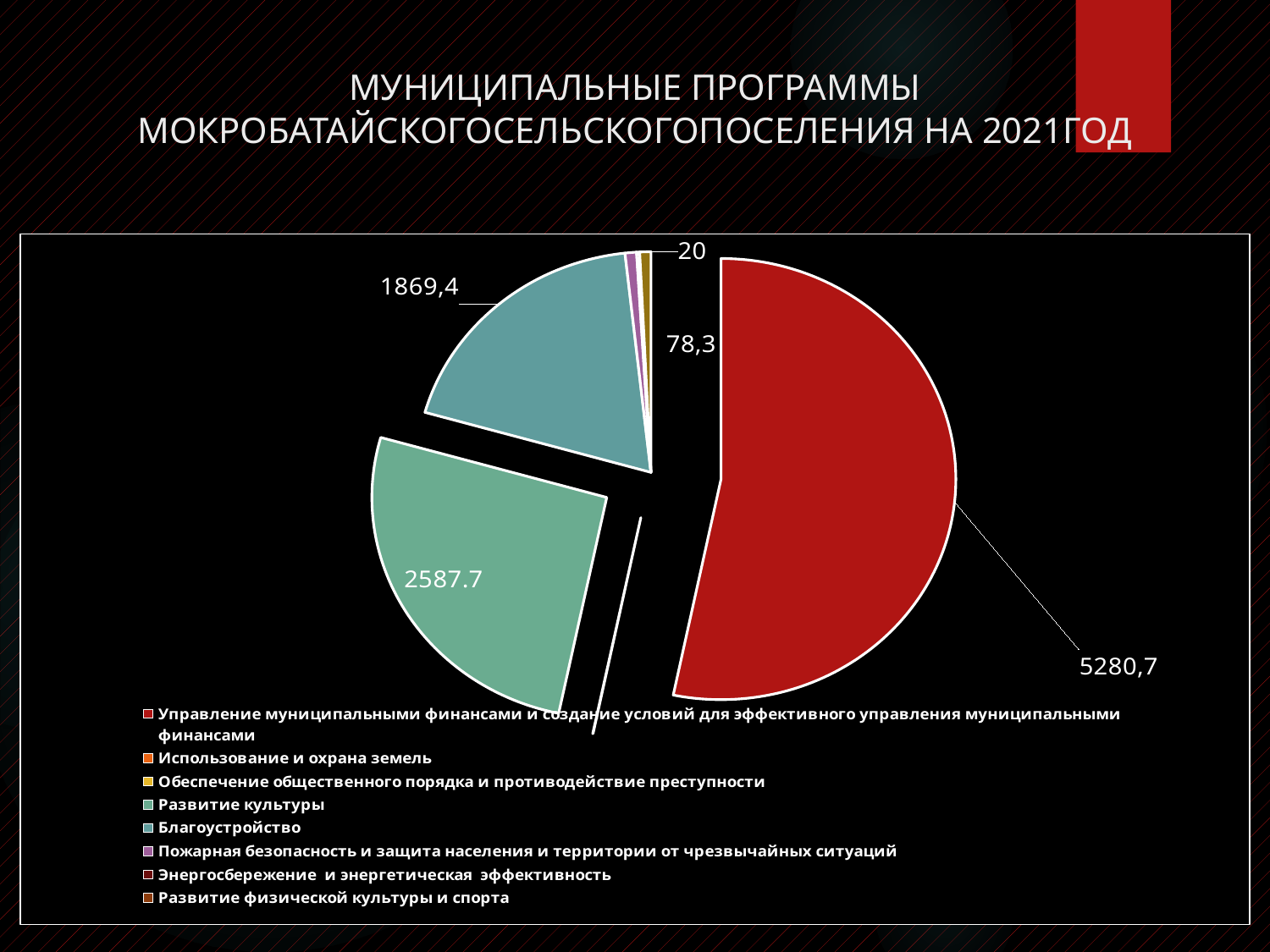
What is the title of the slide? МУНИЦИПАЛЬНЫЕ ПРОГРАММЫ МОКРОБАТАЙСКОГОСЕЛЬСКОГОПОСЕЛЕНИЯ НА 2021ГОД Which is larger, Развитие культуры or Благоустройство? Развитие культуры What is the difference between the values for Управление муниципальными финансами и создание условий для эффективного управления муниципальными финансами and Развитие культуры? 2693 What is the value for Управление муниципальными финансами и создание условий для эффективного управления муниципальными финансами? 5280,7 How many categories does the legend list? 8 What colour is the slice for Развитие культуры? green What type of chart is shown on the slide? pie chart What is the value for Развитие культуры? 2587.7 What is the difference between the values for Развитие культуры and Благоустройство? 718.3 Which category has the largest slice of the pie? Управление муниципальными финансами и создание условий для эффективного управления муниципальными финансами What is the value for Благоустройство? 1869,4